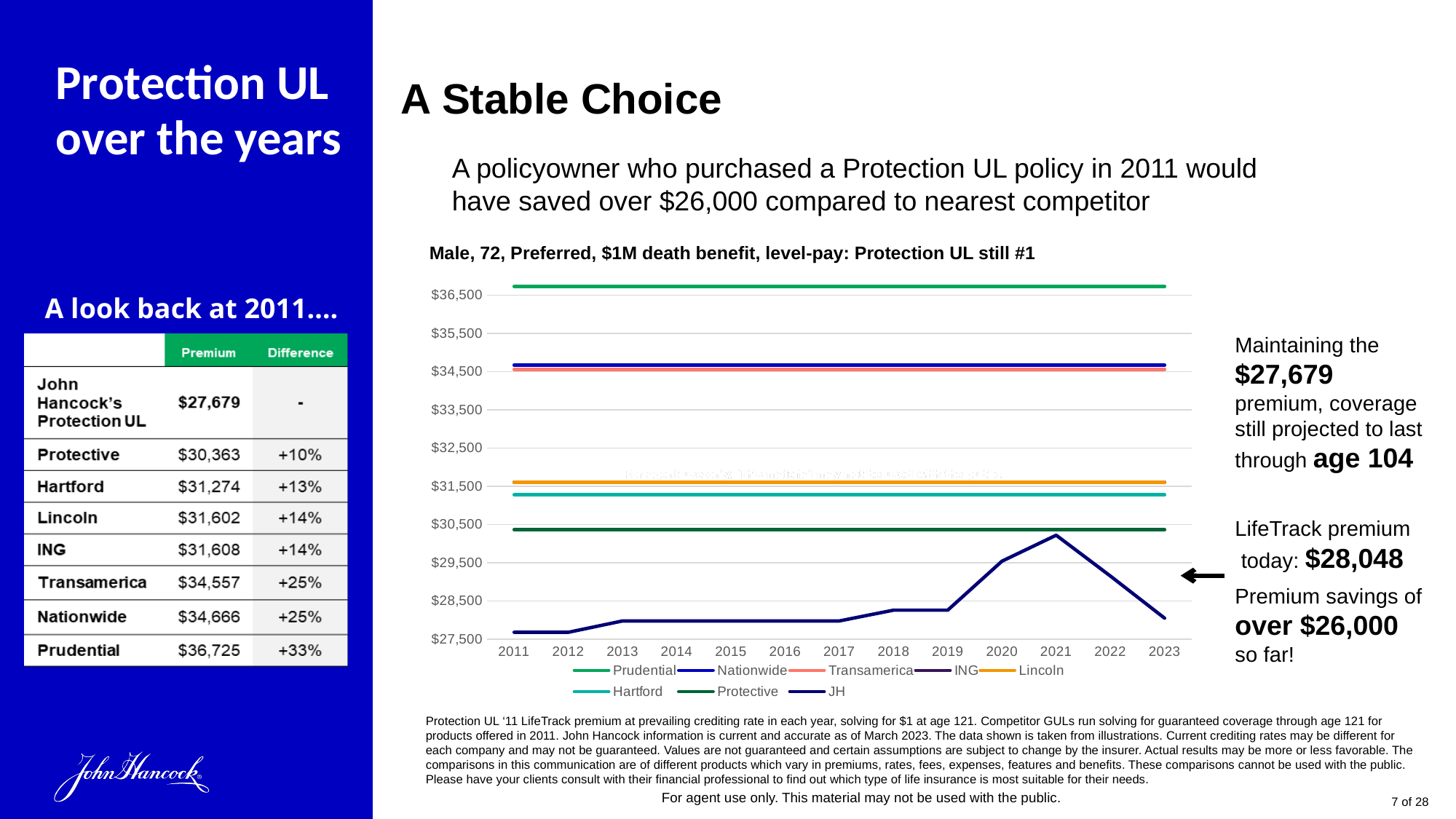
Which is larger, the JH premium in 2021 or the JH premium in 2011? 2021 How many years are shown along the x axis of the chart? 13 Is the value for Prudential greater or less than $36,500? greater Is the value for JH in 2021 greater or less than $29,500? greater Is the value for Protective greater or less than $30,500? less Which series has the lowest premium across the chart? JH Does the JH line rise or fall between 2021 and 2023? fall What kind of chart is shown on the slide? line chart How many series does the chart legend list? 8 What is the title of the chart? Male, 72, Preferred, $1M death benefit, level-pay: Protection UL still #1 Which series has the highest premium across the chart? Prudential